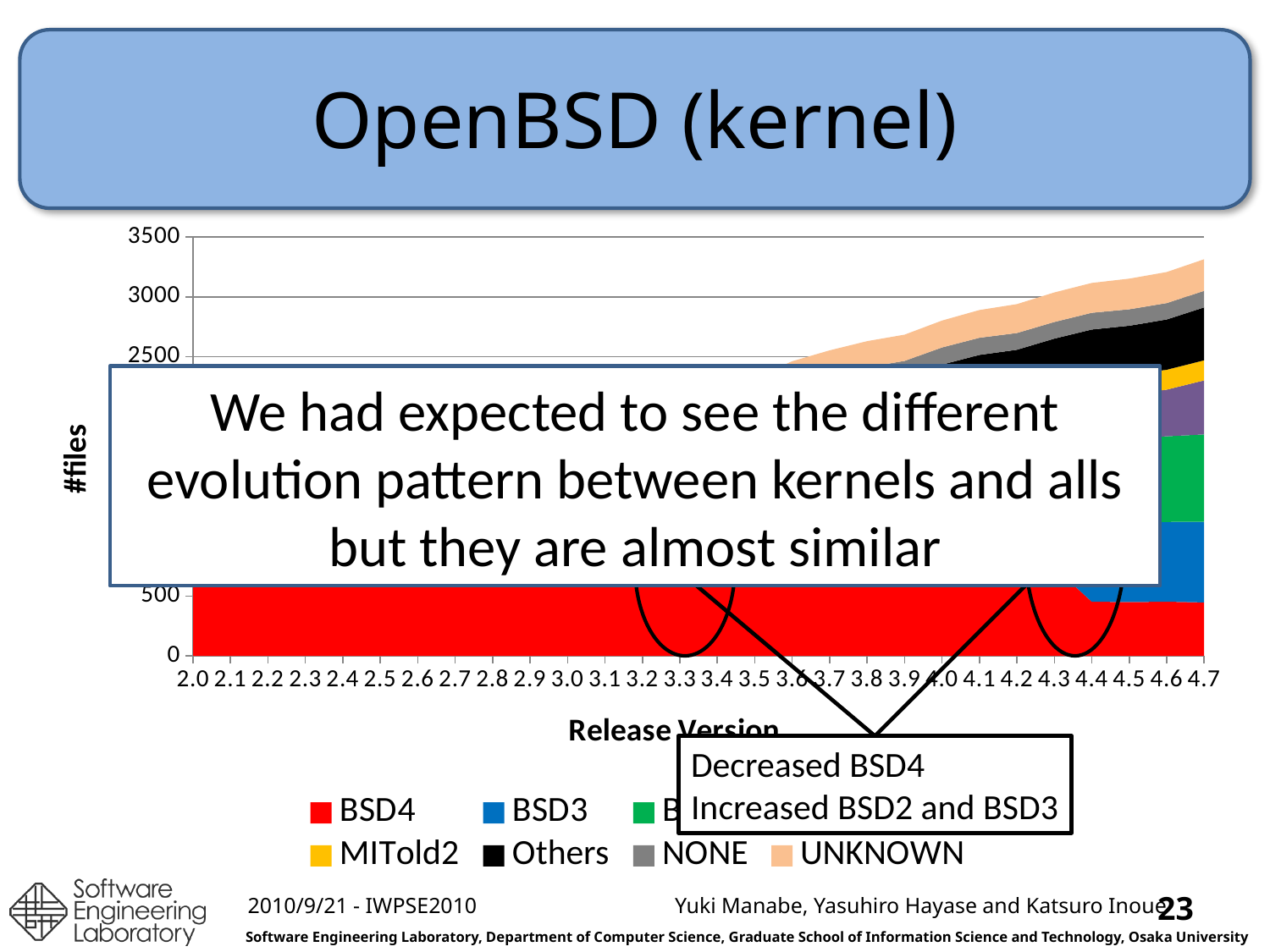
How many release versions are shown along the x axis? 28 Is the total number of files at release 3.6 greater or less than 3000? less Which series is drawn in red at the bottom of the stack? BSD4 From release 3.6 to release 4.7, does the total number of files rise or fall? rise What is the first release version on the x axis? 2.0 What kind of chart is shown on the slide? Stacked area chart What is the highest tick value shown on the y axis? 3500 What is the title of the slide's chart? OpenBSD (kernel) Is the total number of files at release 4.7 greater or less than 3000? greater What is the last release version on the x axis? 4.7